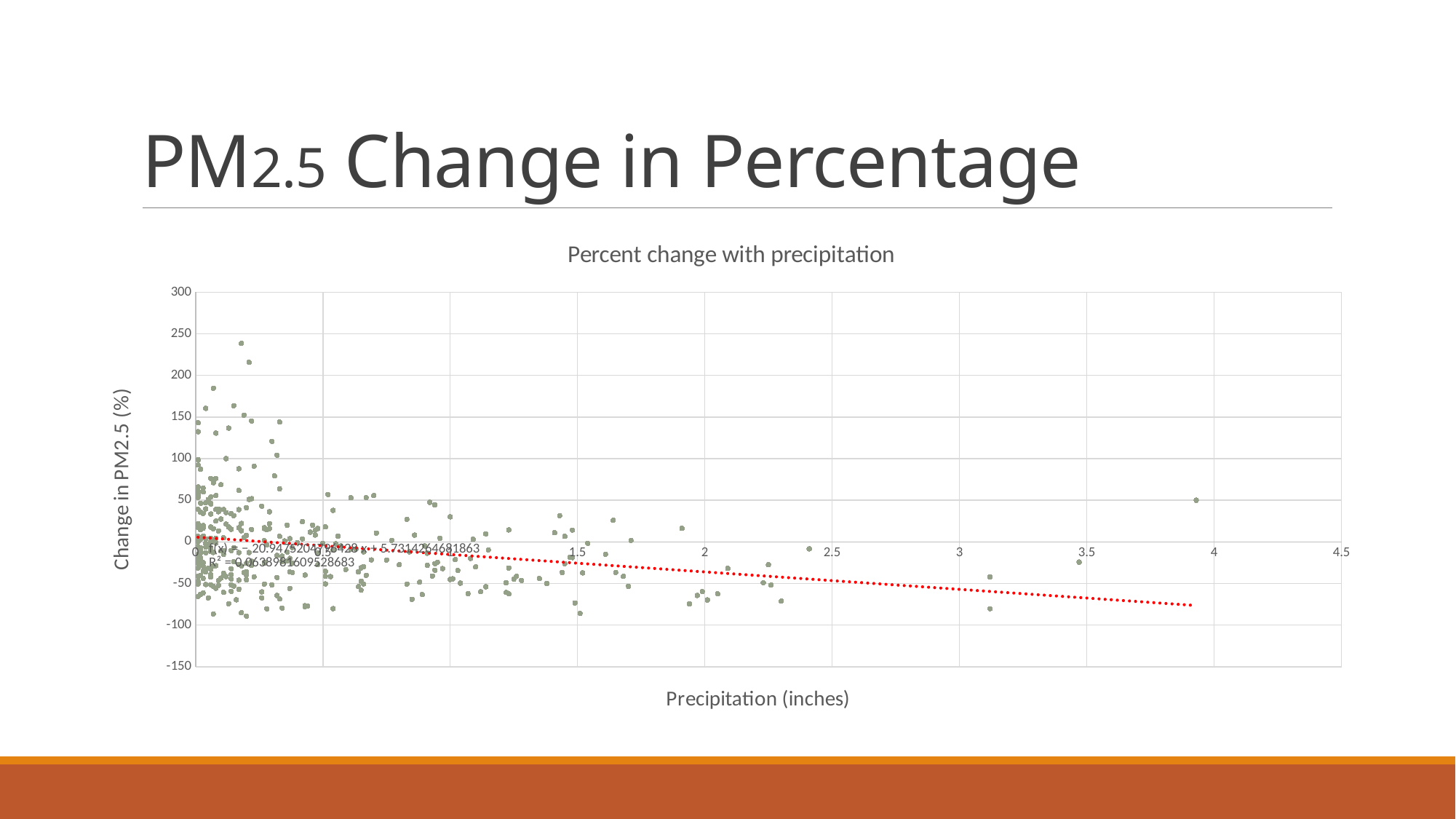
What is the largest tick value shown on the x axis? 4.5 What kind of chart is shown on the slide? Scatter plot What is the title of the chart? Percent change with precipitation What is the minimum value shown on the y axis? -150 Does the dotted trendline rise or fall as precipitation increases? Fall Is the change in PM2.5 for the point at about 3.9 inches of precipitation greater or less than 0? greater Is the highest plotted point's change in PM2.5 greater or less than 200? greater